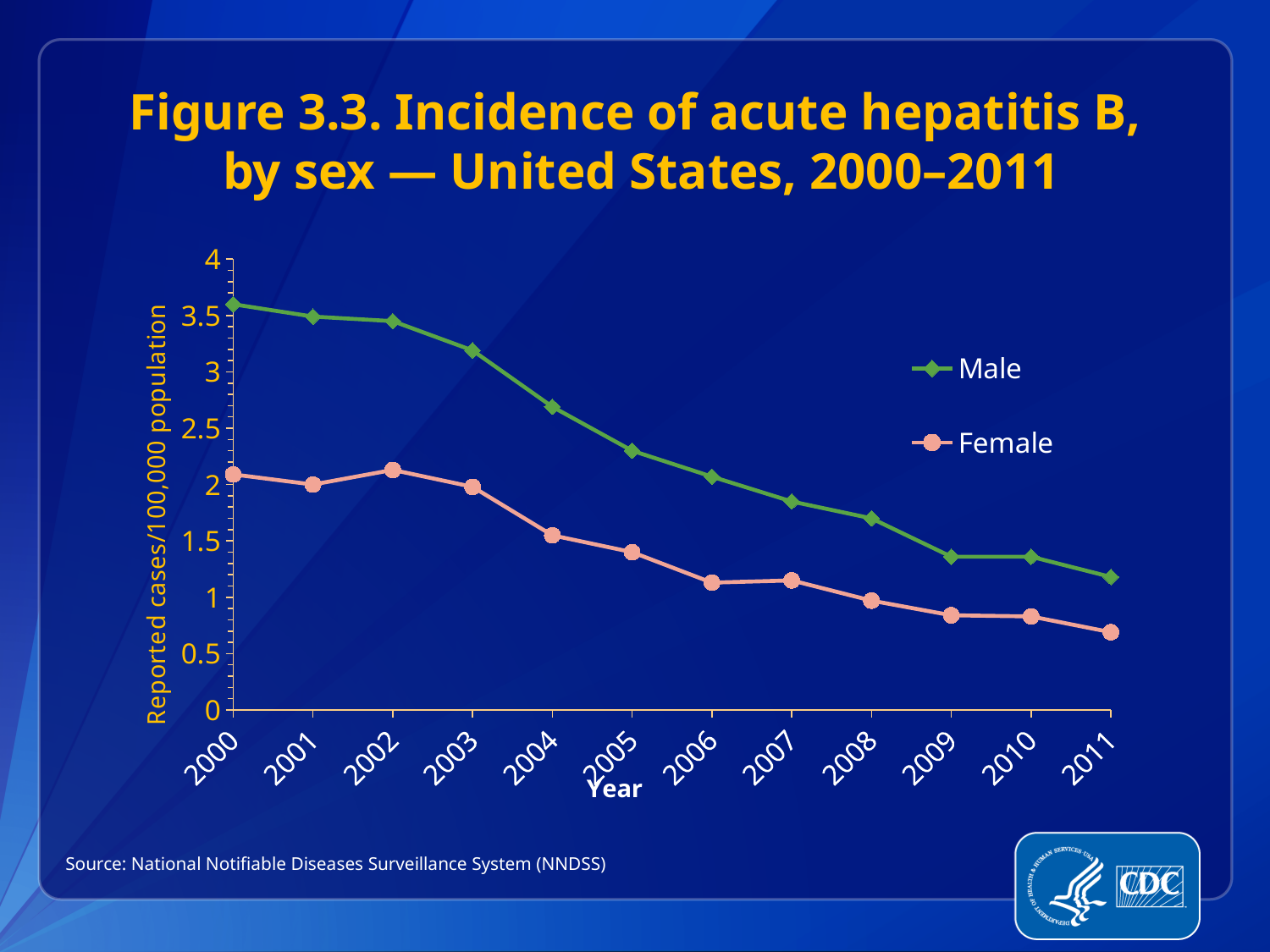
What is the label of the y axis? Reported cases/100,000 population Do the Male values rise or fall from 2000 to 2011? fall Is the Male value for 2004 greater or less than 2.5? greater Is the Male value for 2007 greater or less than 2? less In which year is the Male value lowest? 2011 How many years are plotted along the x axis? 12 How many series does the legend list? 2 In which year is the Male value highest? 2000 In which year is the Female value lowest? 2011 Is the Female value for 2011 greater or less than 1? less What kind of chart is shown on the slide? line chart In 2005, which series has the larger value, Male or Female? Male